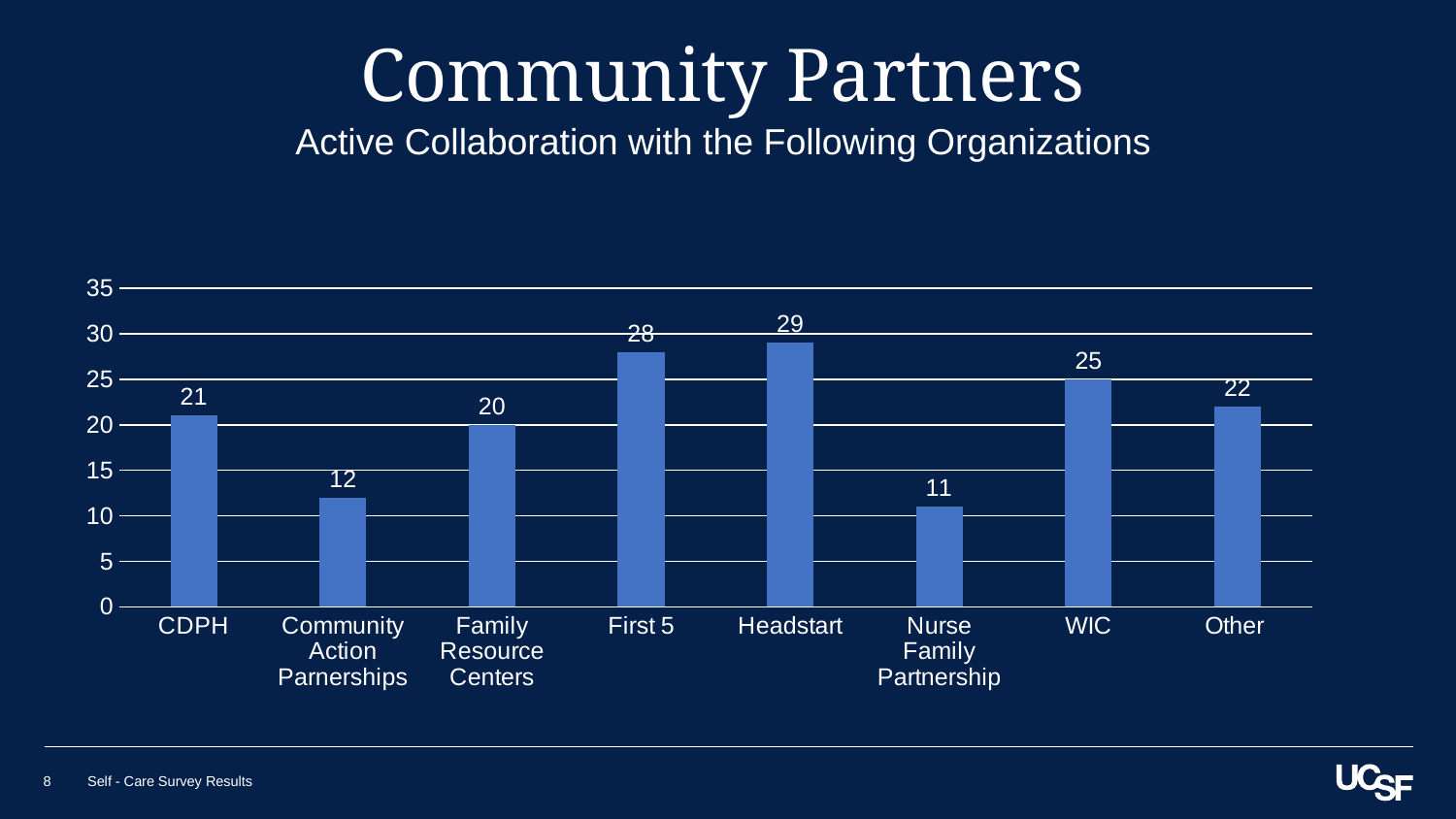
What is the difference between the values for First 5 and CDPH? 7 What is the subtitle shown above the chart? Active Collaboration with the Following Organizations What is the value for WIC? 25 Is the value for Nurse Family Partnership greater or less than 15? less What is the value for Headstart? 29 Which is larger, the value for Family Resource Centers or the value for Other? Other Which organization has the lowest value? Nurse Family Partnership Which organization has the highest value? Headstart What kind of chart is shown on the slide? bar chart What is the difference between the values for Headstart and Nurse Family Partnership? 18 How many organizations are shown on the x axis? 8 What is the value for Community Action Parnerships? 12